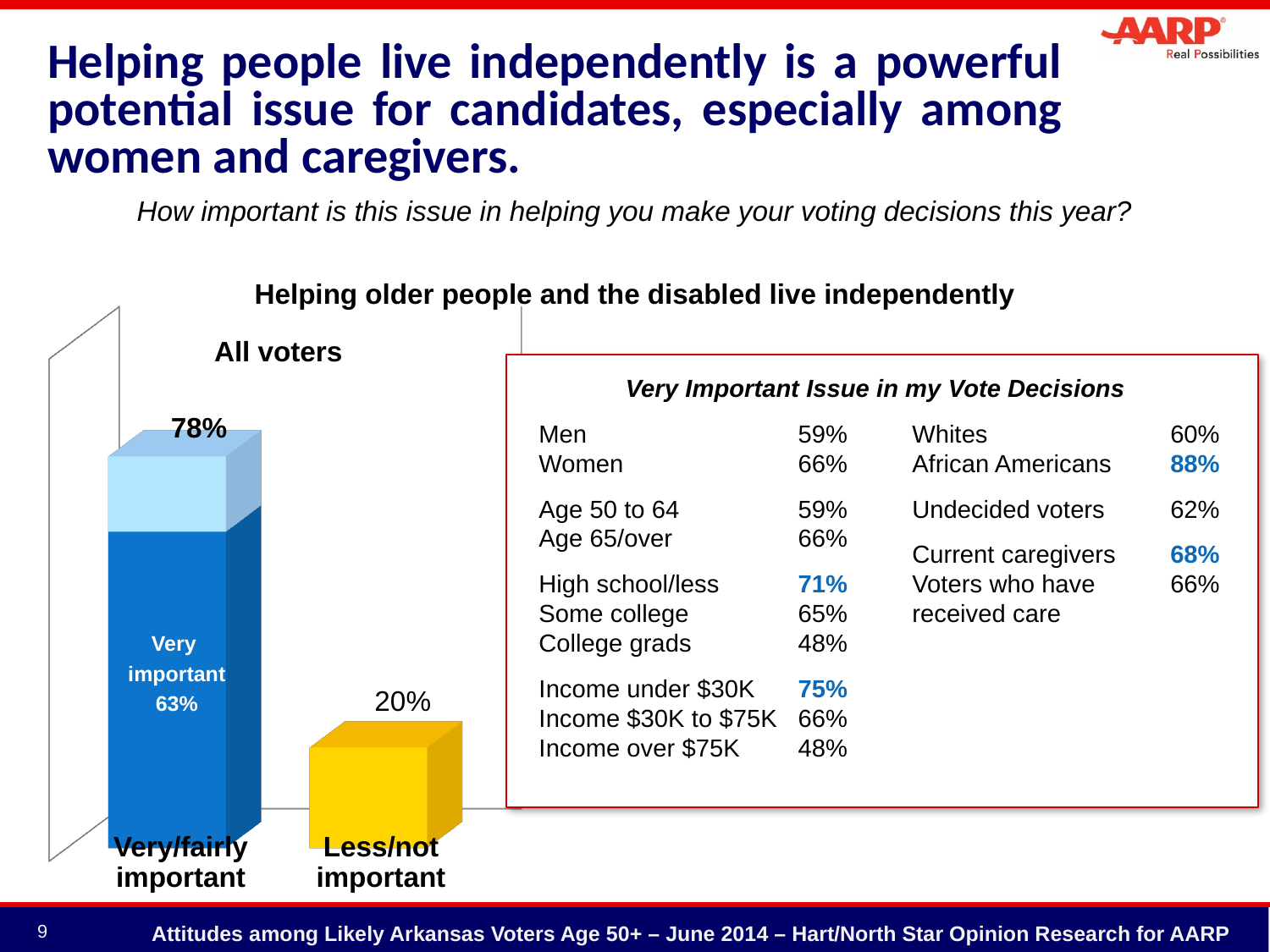
Which category has the lowest value in the chart? Less/not important Which is larger: the "Very/fairly important" bar or the "Less/not important" bar? Very/fairly important Which group of respondents does the chart represent, according to the label above the bars? All voters What percentage of all voters say the issue is "Very important", as labeled inside the bar? 63% What is the value shown for the "Less/not important" bar? 20% What kind of chart is shown on the slide? Bar chart How many categories are shown on the x axis of the chart? 2 What is the total value shown for the "Very/fairly important" bar? 78% What is the title of the chart? Helping older people and the disabled live independently What is the difference in percentage points between the "Very/fairly important" bar (78%) and the "Less/not important" bar (20%)? 58 percentage points Which category has the highest value in the chart? Very/fairly important What is the total of the stacked "Very/fairly important" bar? 78%